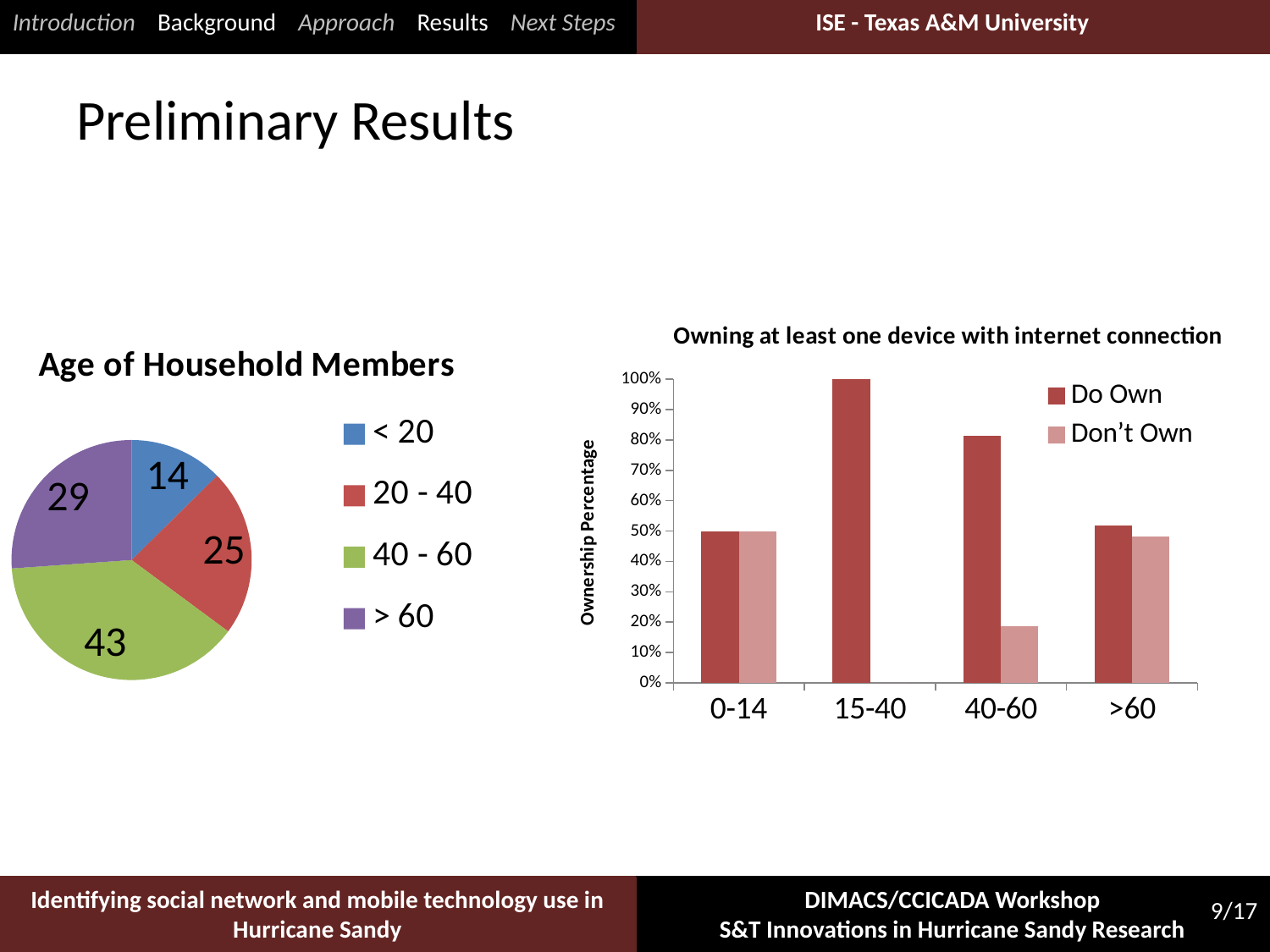
In the 'Age of Household Members' chart, which age group has the smallest slice? < 20 In the 'Age of Household Members' chart, what is the difference between the > 60 value and the 20 - 40 value? 4 In the 'Owning at least one device with internet connection' chart, what is the Do Own value for the 15-40 group? 100% In the 'Age of Household Members' chart, what is the value for the 40 - 60 slice? 43 In the 'Age of Household Members' chart, how many slices does the pie have? 4 In the 'Owning at least one device with internet connection' chart, is the Don't Own value for the 40-60 group greater or less than 30%? less What kind of chart is 'Age of Household Members'? pie chart In the 'Owning at least one device with internet connection' chart, which is larger for the 40-60 group, Do Own or Don't Own? Do Own In the 'Age of Household Members' chart, which age group has the largest slice? 40 - 60 In the 'Age of Household Members' chart, what is the value for the < 20 slice? 14 What is the y-axis title of the 'Owning at least one device with internet connection' chart? Ownership Percentage How many series does the legend of the 'Owning at least one device with internet connection' chart list? 2